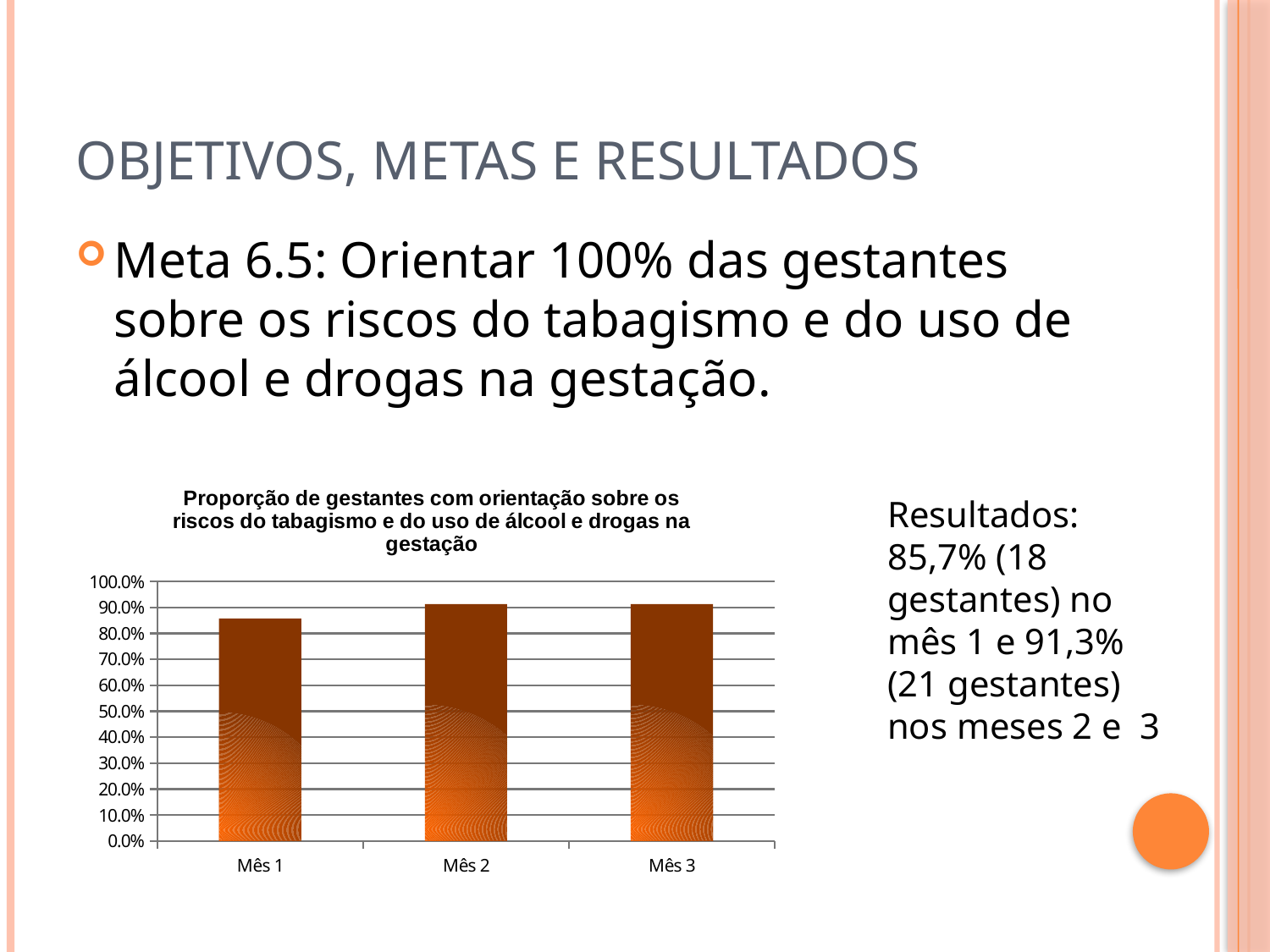
What kind of chart is shown on the slide? bar chart Does the value rise or fall from Mês 1 to Mês 2? rise Is the value for Mês 1 greater or less than 90.0%? less Which is larger, the value for Mês 1 or the value for Mês 2? Mês 2 What is the highest value shown on the y axis of the chart? 100.0% What is the title of the chart? Proporção de gestantes com orientação sobre os riscos do tabagismo e do uso de álcool e drogas na gestação How many categories (months) are shown on the x axis of the chart? 3 Is the value for Mês 1 greater or less than 80.0%? greater Which month has the lowest bar in the chart? Mês 1 Is the value for Mês 2 greater or less than 90.0%? greater Which is larger, the value for Mês 3 or the value for Mês 1? Mês 3